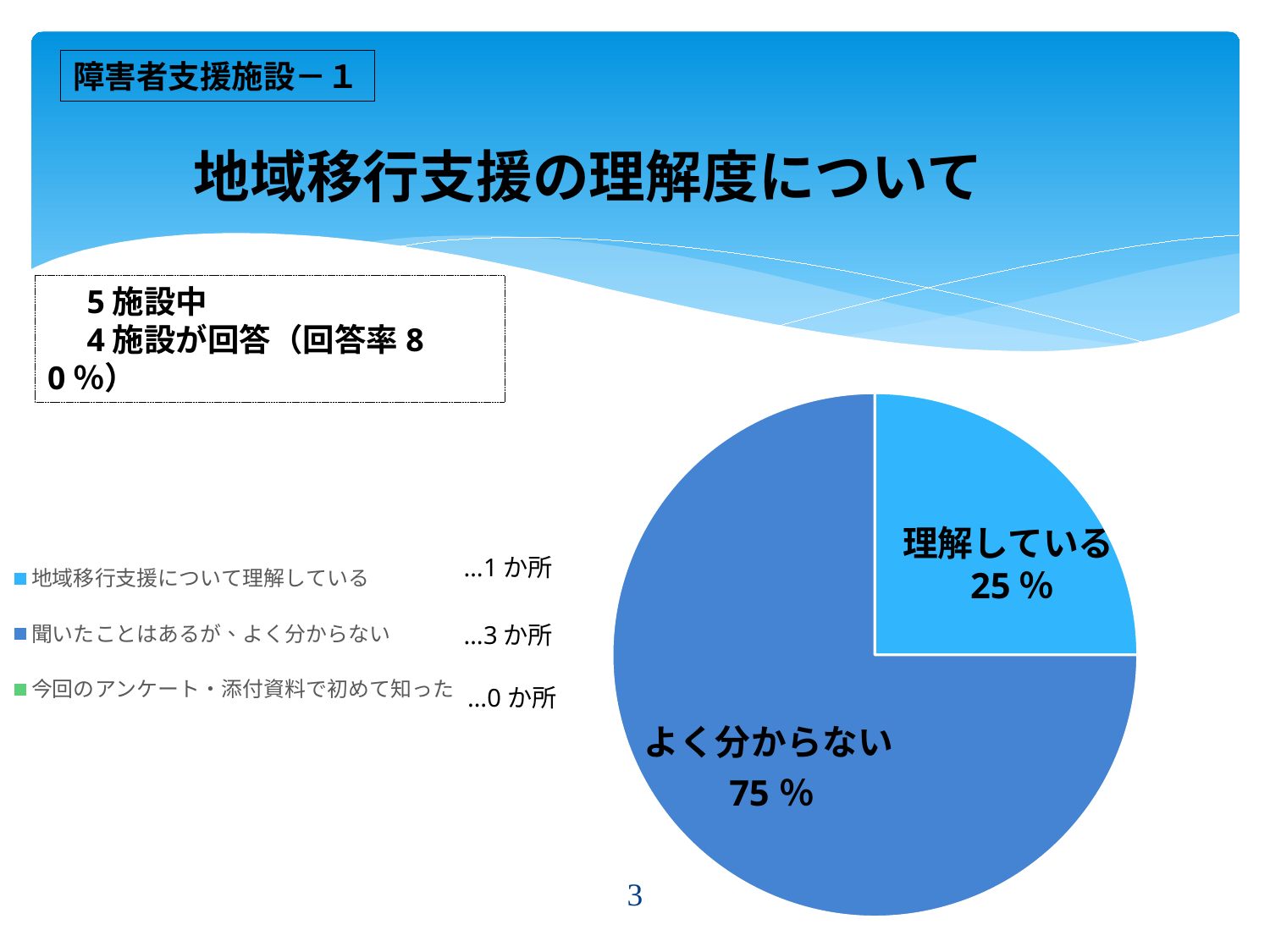
What is the title of the slide containing the chart? 地域移行支援の理解度について Which of the two labelled slices is smaller, 理解している or よく分からない? 理解している What kind of chart is shown on the slide? pie chart Which slice of the pie is the largest? よく分からない How many entries does the legend list? 3 How many facilities answered 今回のアンケート・添付資料で初めて知った? 0か所 What share of the pie does the 理解している slice represent? 25％ What colour is the 理解している slice of the pie? light blue What share of the pie does the よく分からない slice represent? 75％ How many facilities answered 地域移行支援について理解している? 1か所 What is the difference in percentage points between the よく分からない slice and the 理解している slice? 50 How many facilities answered 聞いたことはあるが、よく分からない? 3か所